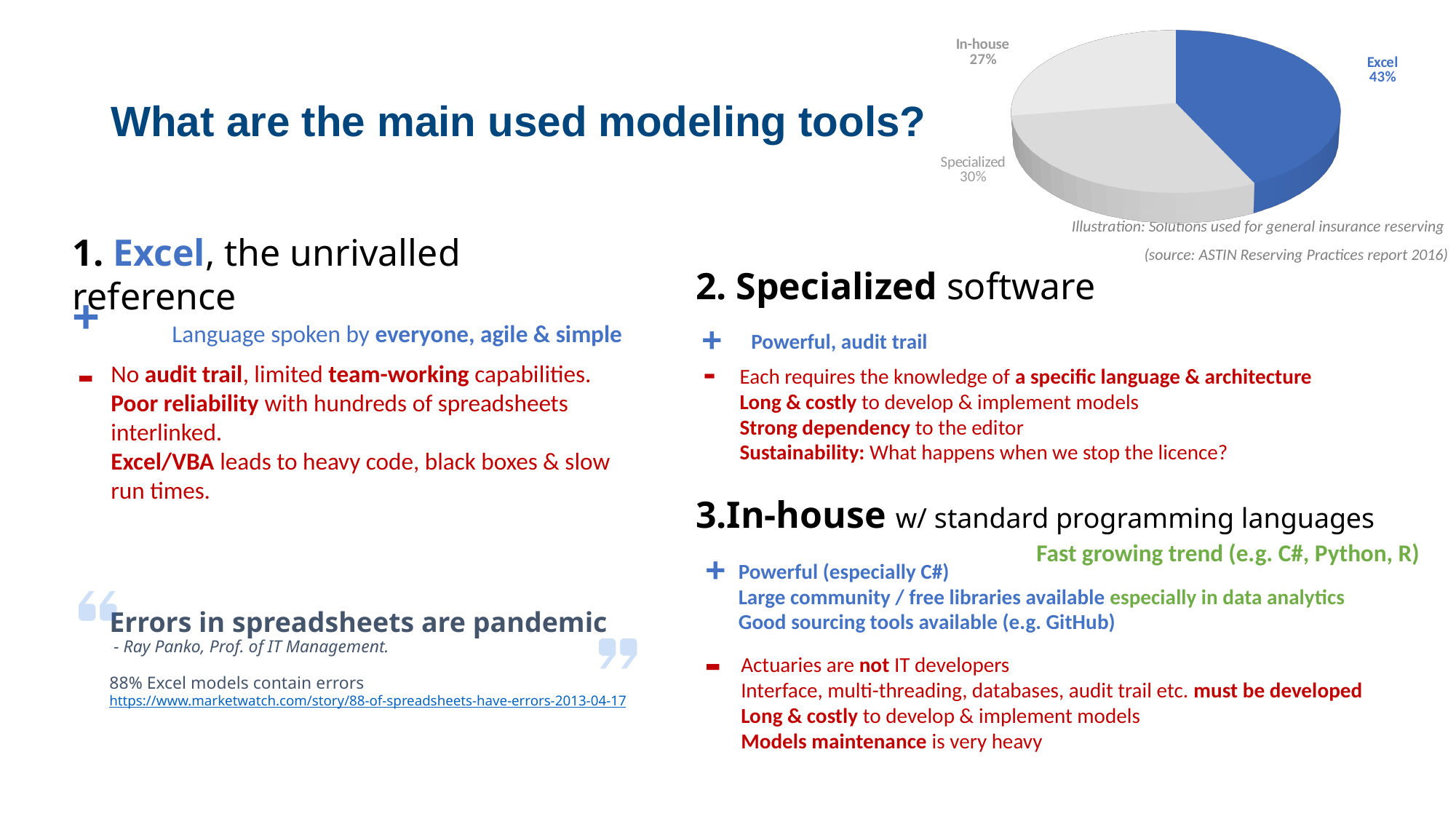
Which slice of the pie chart is the largest? Excel What is the difference in percentage points between the Specialized and In-house slices? 3 Which slice of the pie chart is coloured blue? Excel How many slices does the pie chart have? 3 What kind of chart is shown on the slide? Pie chart Which is larger, the Specialized slice or the In-house slice? Specialized According to the caption, what is the source of the pie chart data? ASTIN Reserving Practices report 2016 What is the difference in percentage points between the Excel and In-house slices? 16 What share of the pie does In-house have? 27% What share of the pie does Excel have? 43% Which slice of the pie chart is the smallest? In-house What share of the pie does Specialized have? 30%